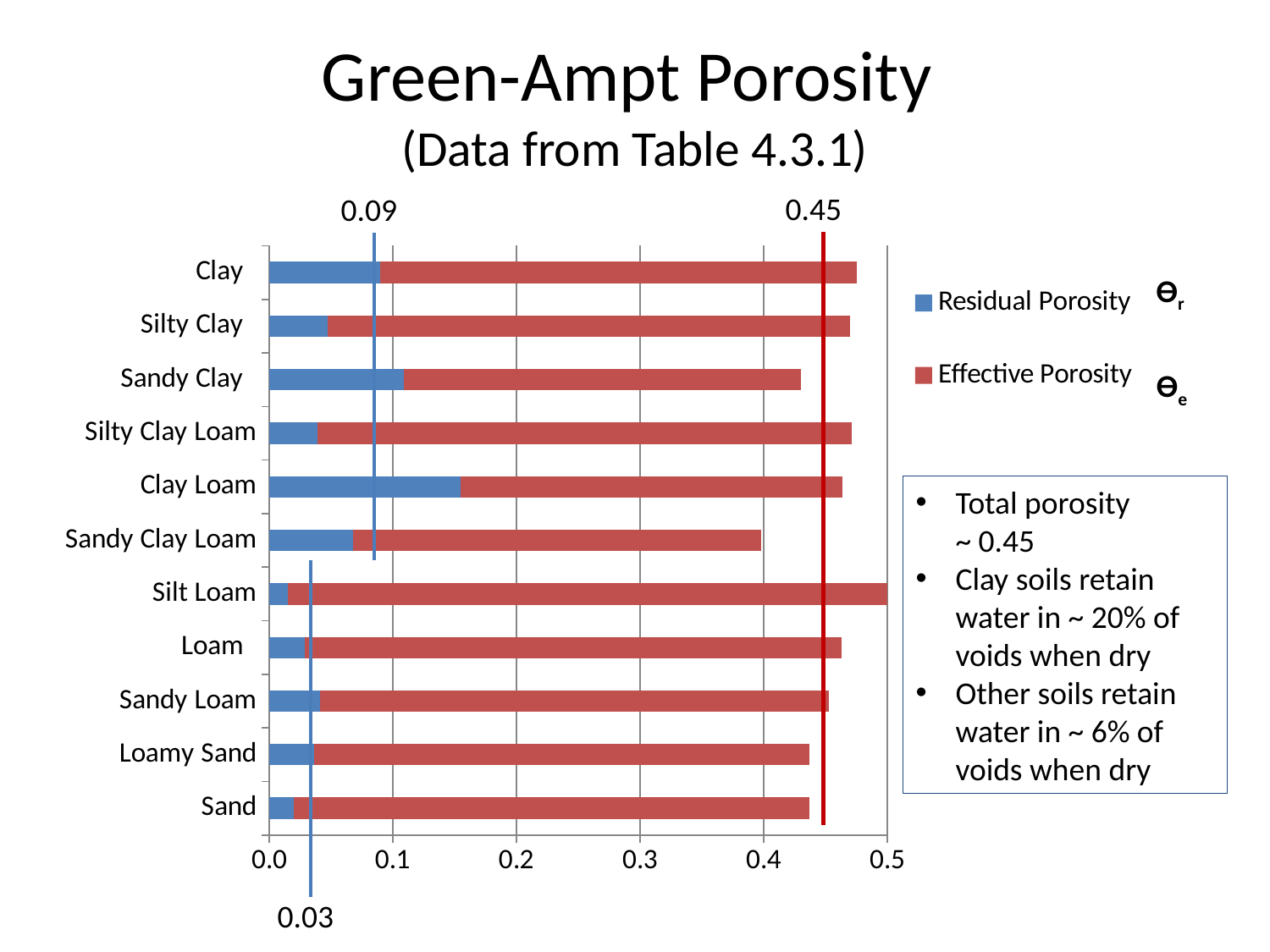
Which soil type has the shortest total bar length (total porosity)? Sandy Clay Loam Which soil type has the largest total bar length (total porosity)? Silt Loam Is the Residual Porosity value for Sand greater or less than 0.1? less How many soil types are plotted on the chart? 11 What kind of chart is shown on the slide? Stacked bar chart What is the title of the chart on the slide? Green-Ampt Porosity (Data from Table 4.3.1) What are the two series named in the legend? Residual Porosity and Effective Porosity How many series does the legend list? 2 Which soil type has the largest Residual Porosity segment? Clay Loam Which has the larger Residual Porosity segment, Clay or Sand? Clay Is the Residual Porosity value for Clay Loam greater or less than 0.1? greater Is the total bar length for Clay greater or less than 0.4? greater